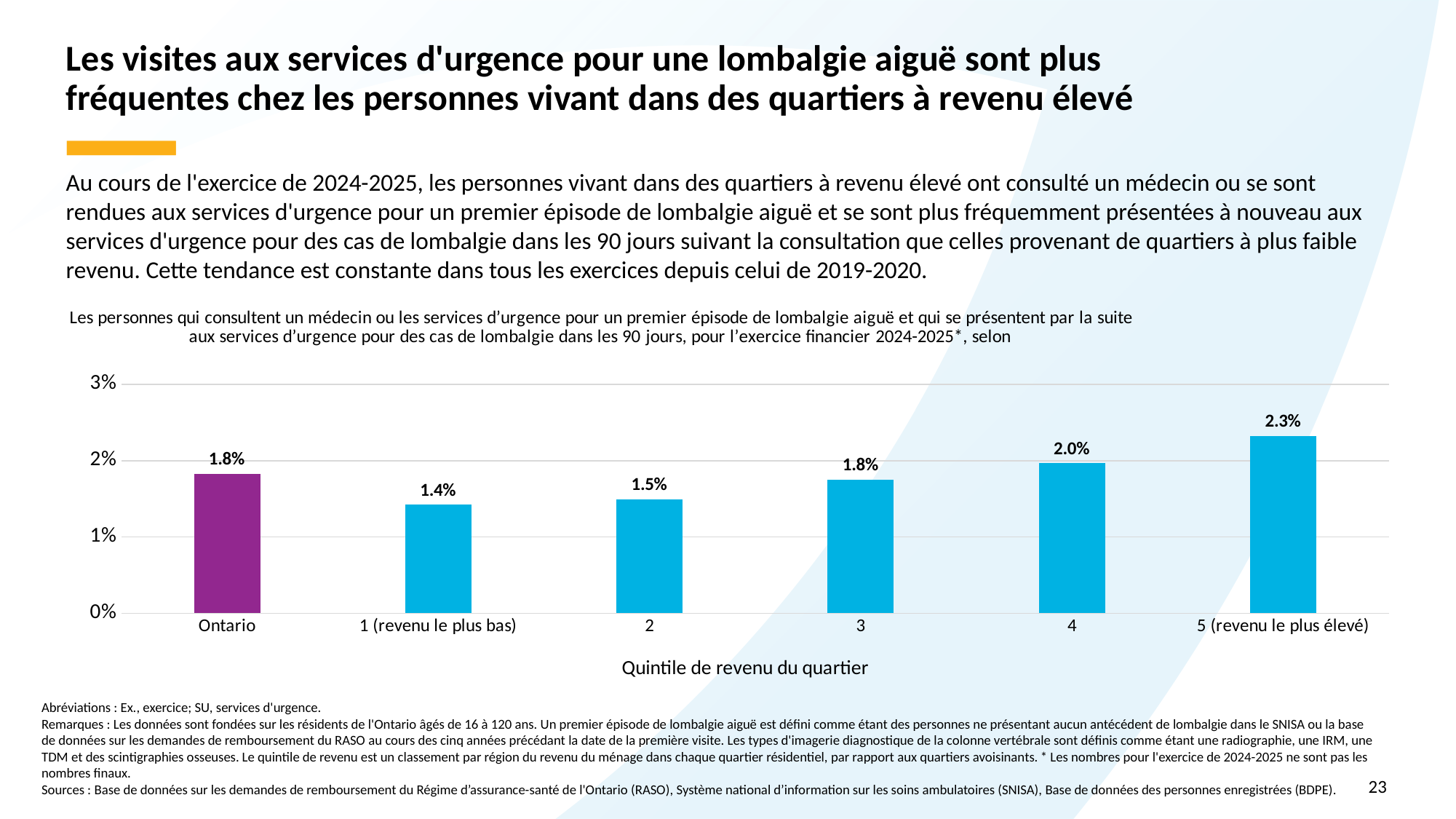
What is the value for Ontario? 1.8% Is the value for quintile 3 greater or less than 2%? less What is the value for quintile 4? 2.0% What is the value for quintile 1 (revenu le plus bas)? 1.4% What kind of chart is shown on the slide? Bar chart What is the value for quintile 5 (revenu le plus élevé)? 2.3% Which category has the highest value? 5 (revenu le plus élevé) Which category has the lowest value? 1 (revenu le plus bas) What is the difference between the values for quintile 5 (revenu le plus élevé) and quintile 1 (revenu le plus bas)? 0.9% Which is larger, the value for quintile 4 or the value for quintile 2? Quintile 4 How many bars are shown in the chart? 6 Do the values rise or fall from quintile 1 to quintile 5 along the x axis? Rise